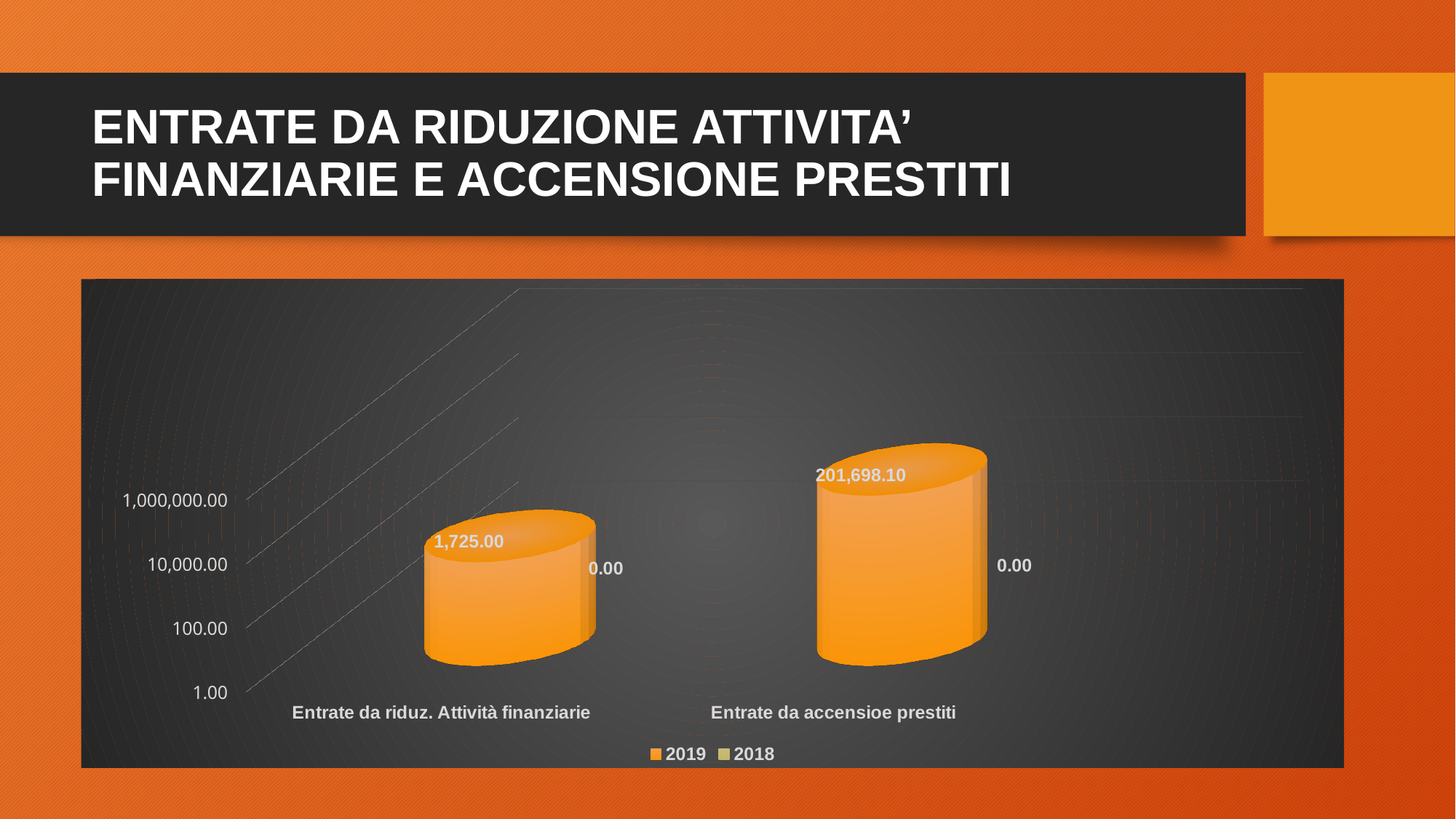
Which category has the lowest 2019 value? Entrate da riduz. Attività finanziarie What is the 2018 value for Entrate da accensioe prestiti? 0.00 Which is larger: the 2019 value for Entrate da riduz. Attività finanziarie or the 2019 value for Entrate da accensioe prestiti? Entrate da accensioe prestiti How many series does the chart legend list? 2 Which category has the highest 2019 value? Entrate da accensioe prestiti What is the difference between the 2019 values for Entrate da accensioe prestiti and Entrate da riduz. Attività finanziarie? 199,973.10 What is the 2018 value for Entrate da riduz. Attività finanziarie? 0.00 What kind of chart is shown on the slide? bar chart What is the 2019 value for Entrate da accensioe prestiti? 201,698.10 Is the 2019 value for Entrate da accensioe prestiti greater or less than 1,000,000.00? less How many categories are shown on the x axis of the chart? 2 What is the 2019 value for Entrate da riduz. Attività finanziarie? 1,725.00